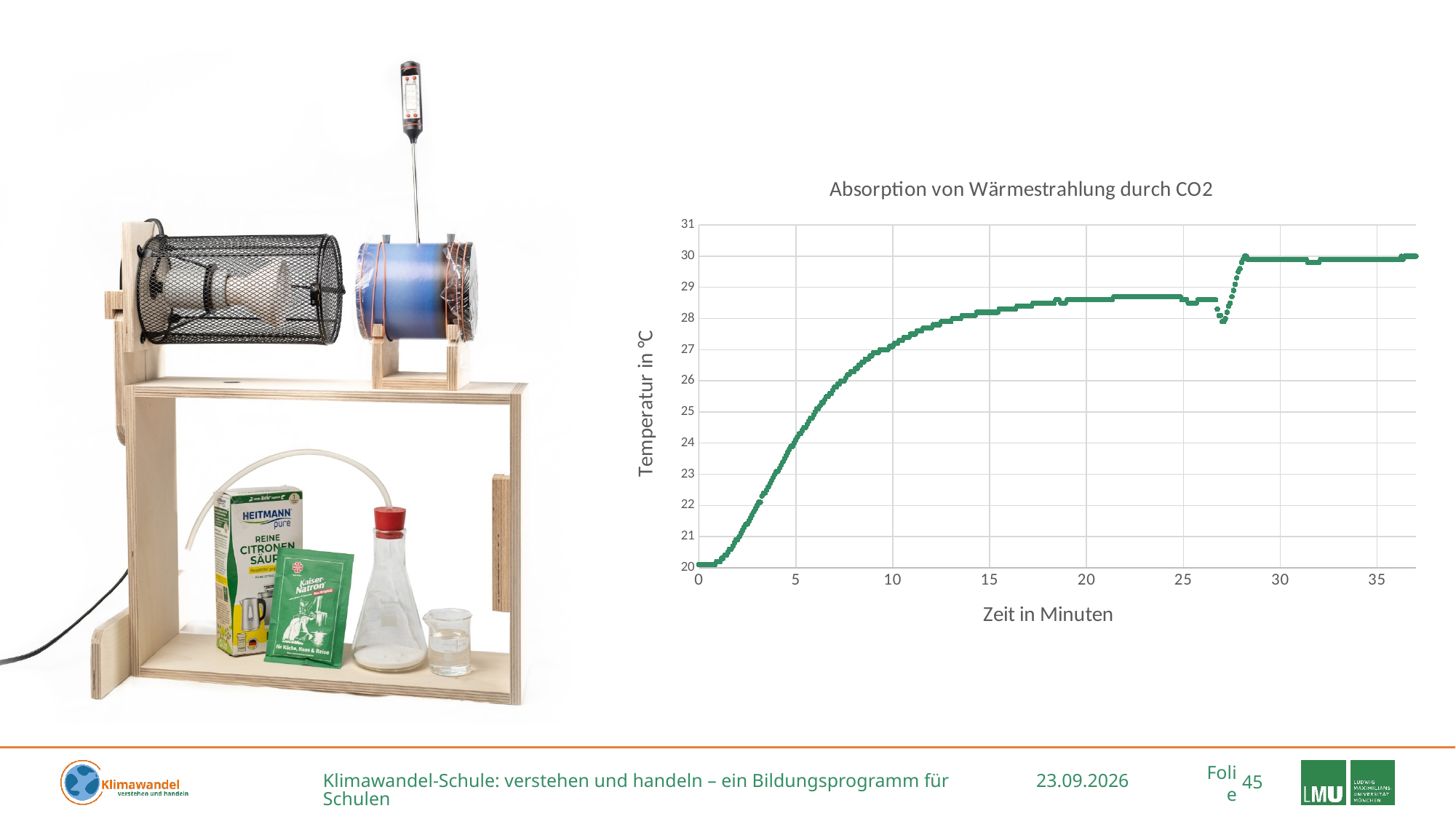
Does the temperature rise or fall over the first 20 minutes? rise What is the label of the x axis of the chart? Zeit in Minuten What kind of chart is shown on the slide? scatter chart Is the temperature at 10 minutes greater or less than 26? greater Which is higher, the temperature at 25 minutes or at 35 minutes? 35 minutes Is the temperature at 5 minutes greater or less than 23? greater Which is higher, the temperature at 5 minutes or at 15 minutes? 15 minutes Is the temperature at 2 minutes greater or less than 22? less What is the title of the chart? Absorption von Wärmestrahlung durch CO2